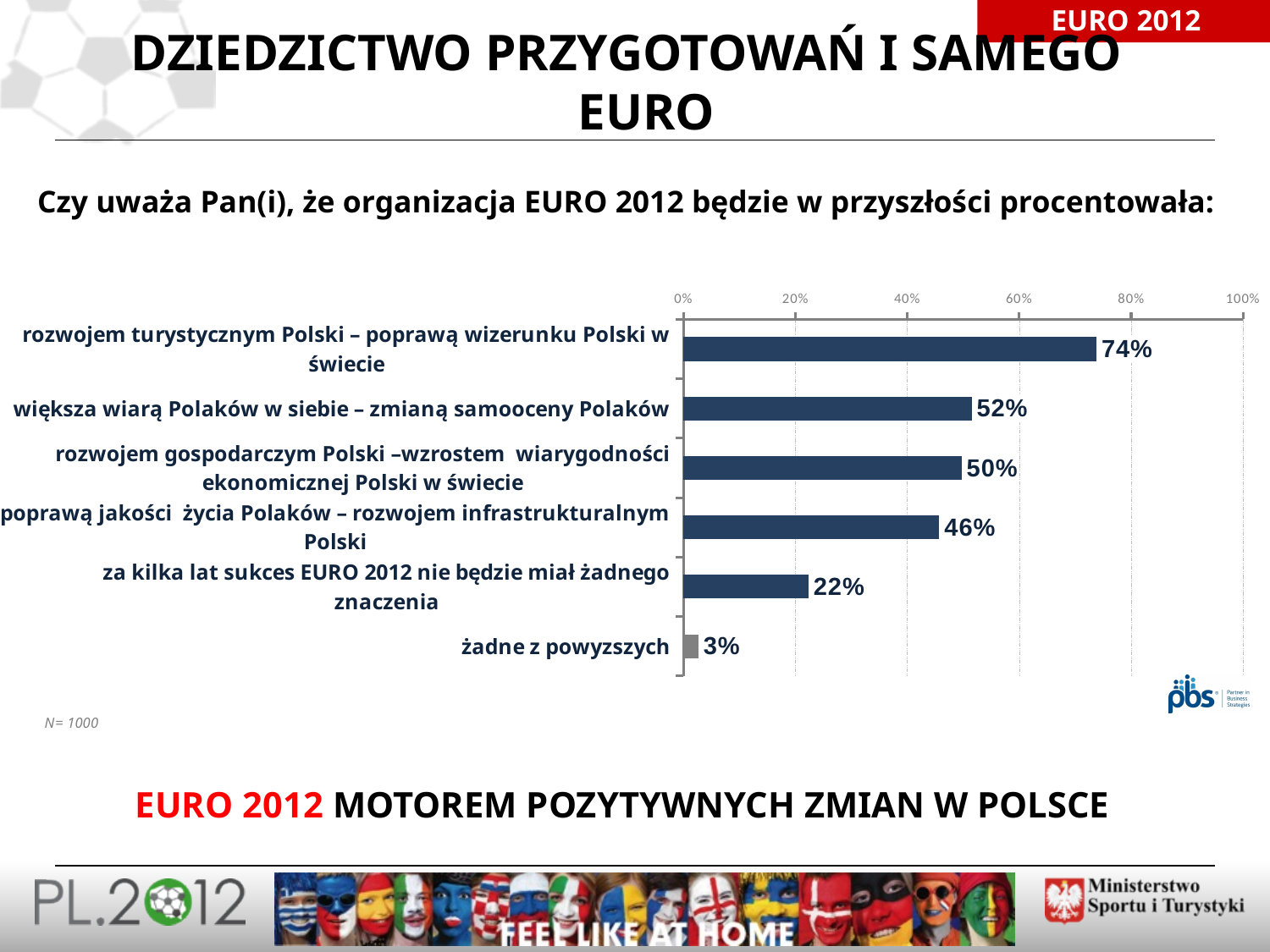
Which is larger: the value for 'rozwojem gospodarczym Polski' or the value for 'poprawą jakości życia Polaków'? rozwojem gospodarczym Polski What is the value for 'za kilka lat sukces EURO 2012 nie będzie miał żadnego znaczenia'? 22% What is the sample size (N) stated below the chart? N= 1000 How many categories are shown in the chart? 6 What is the difference between the value for 'rozwojem turystycznym Polski' and the value for 'większa wiarą Polaków w siebie'? 22% What kind of chart is shown on the slide? bar chart What is the value for 'większa wiarą Polaków w siebie – zmianą samooceny Polaków'? 52% What is the value for 'żadne z powyzszych'? 3% Which category has the highest value? rozwojem turystycznym Polski – poprawą wizerunku Polski w świecie Is the value for 'poprawą jakości życia Polaków – rozwojem infrastrukturalnym Polski' greater or less than 40%? greater Which category has the lowest value? żadne z powyzszych What percentage of respondents said EURO 2012 will pay off through the tourism development of Poland (rozwojem turystycznym Polski)? 74%